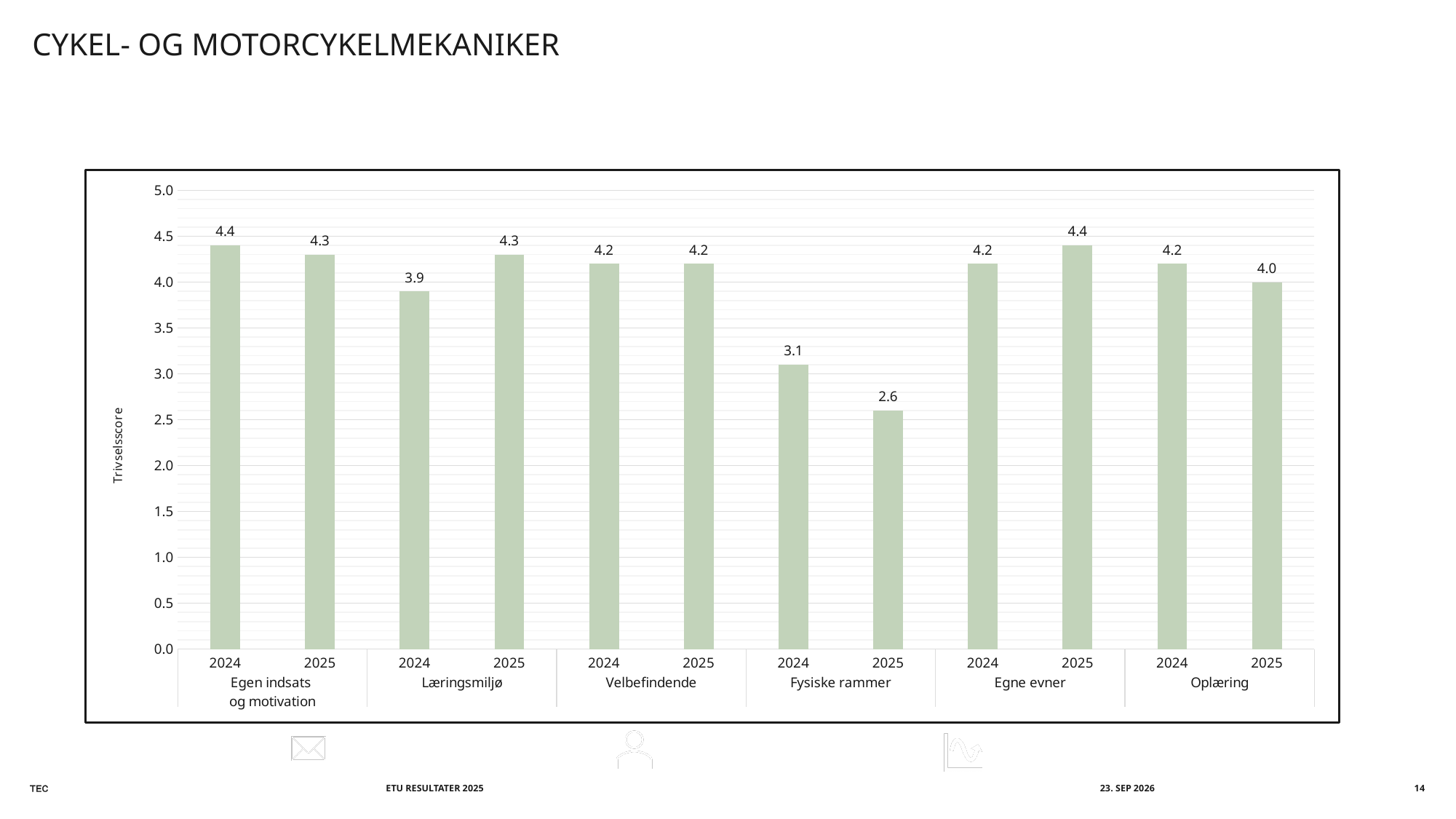
What is the Trivselsscore for Egne evner in 2025? 4.4 What is the Trivselsscore for Læringsmiljø in 2024? 3.9 What kind of chart is shown on the slide? bar chart What is the difference between the 2024 and 2025 values for Fysiske rammer? 0.5 What is the difference between the 2024 and 2025 values for Læringsmiljø? 0.4 What is the label of the vertical axis? Trivselsscore Which is larger: the 2024 value for Egen indsats og motivation or the 2024 value for Læringsmiljø? Egen indsats og motivation 2024 What is the Trivselsscore for Fysiske rammer in 2025? 2.6 How many bars are plotted on the chart? 12 Which bar has the lowest value on the chart? Fysiske rammer 2025 What is the Trivselsscore for Oplæring in 2025? 4.0 Is the value for Fysiske rammer in 2024 greater or less than 3.5? less